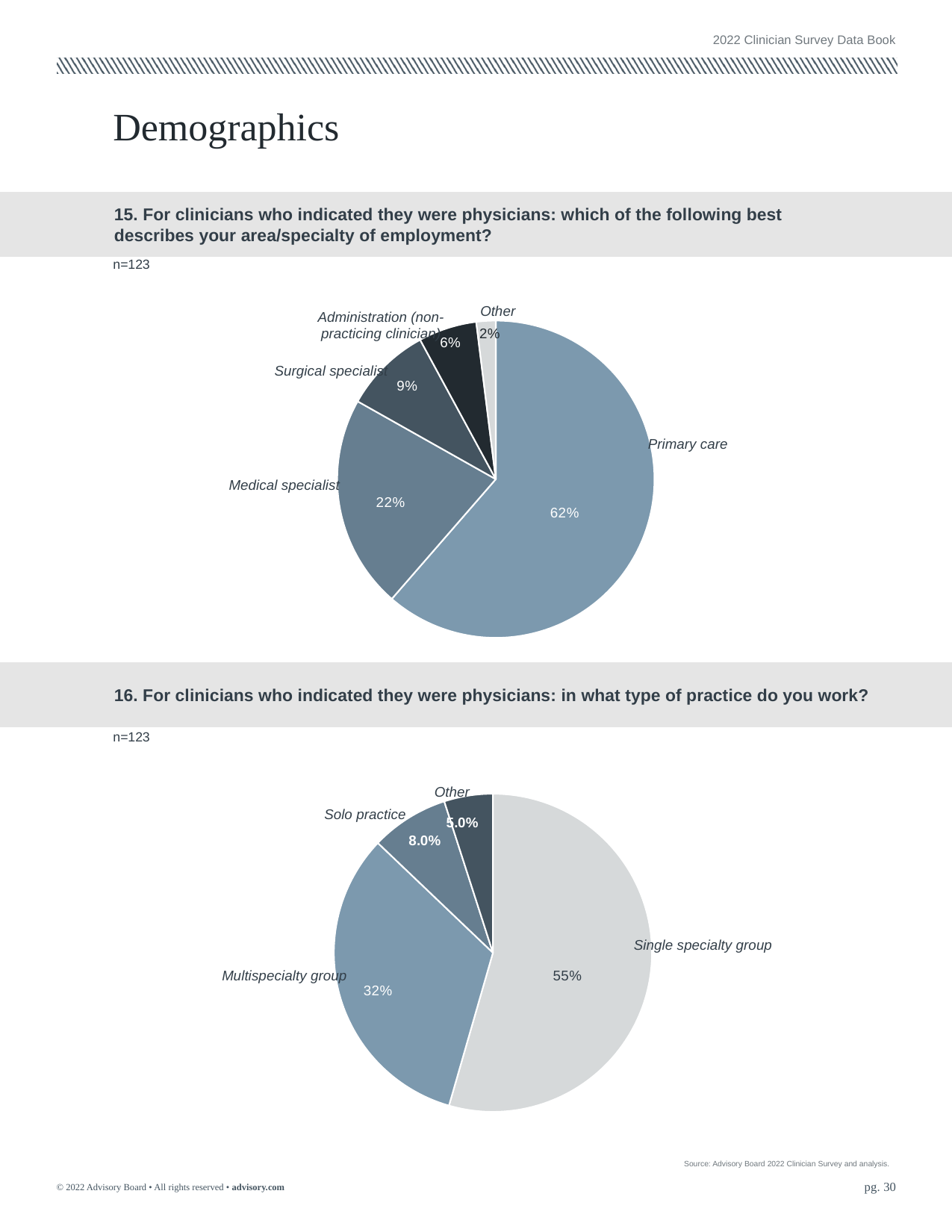
In the bottom chart (question 16), what percentage of physicians work in Solo practice? 8.0% In the top chart (question 15), which category has the smallest share? Other In the bottom chart (question 16), which type of practice has the largest share? Single specialty group What is the sample size (n) shown for question 16? n=123 In the top chart (question 15), how many categories are shown in the pie? 5 In the top chart (question 15), what percentage of physicians indicated Surgical specialist? 9% What type of chart is used for question 15 (area/specialty of employment)? Pie chart In the top chart (question 15), what is the difference in percentage points between Primary care and Medical specialist? 40 In the bottom chart (question 16, type of practice), what percentage of physicians work in a Single specialty group? 55% In the bottom chart (question 16), which is larger: Multispecialty group or Solo practice? Multispecialty group In the top chart (question 15), what percentage of physicians indicated Medical specialist? 22% In the top chart (question 15, area/specialty of employment), what percentage of physicians indicated Primary care? 62%